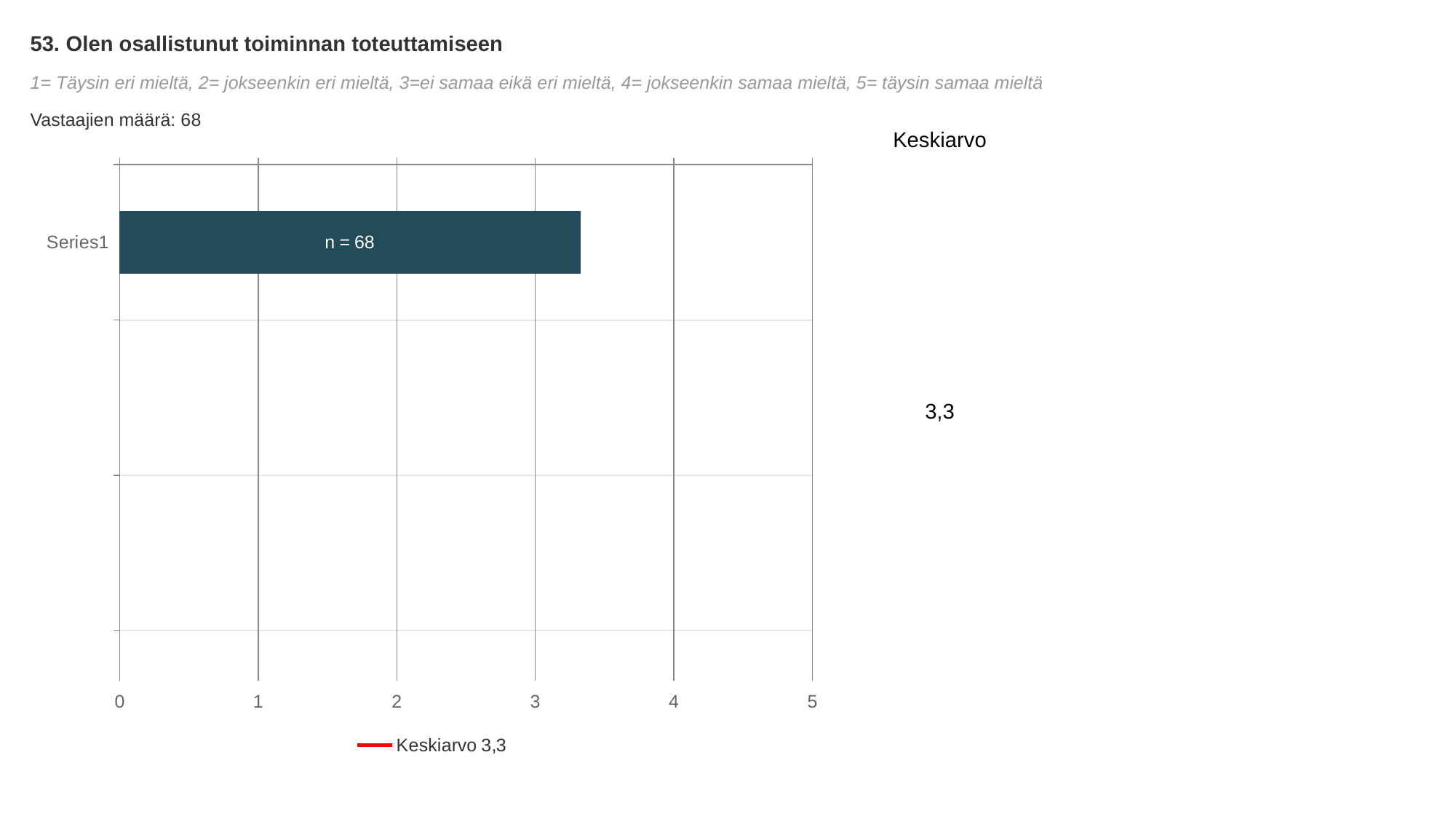
Is the value of the Series1 bar greater or less than 3? greater How many bars are plotted in the chart? 1 What is the number of respondents (Vastaajien määrä) stated on the slide? 68 Is the value of the Series1 bar greater or less than 4? less What is the category label of the single bar in the chart? Series1 What is the maximum value shown on the x axis? 5 What is the data label printed on the Series1 bar? n = 68 What text does the legend entry below the chart show? Keskiarvo 3,3 What is the Keskiarvo (mean) value shown on the slide? 3,3 What kind of chart is shown on the slide? bar chart